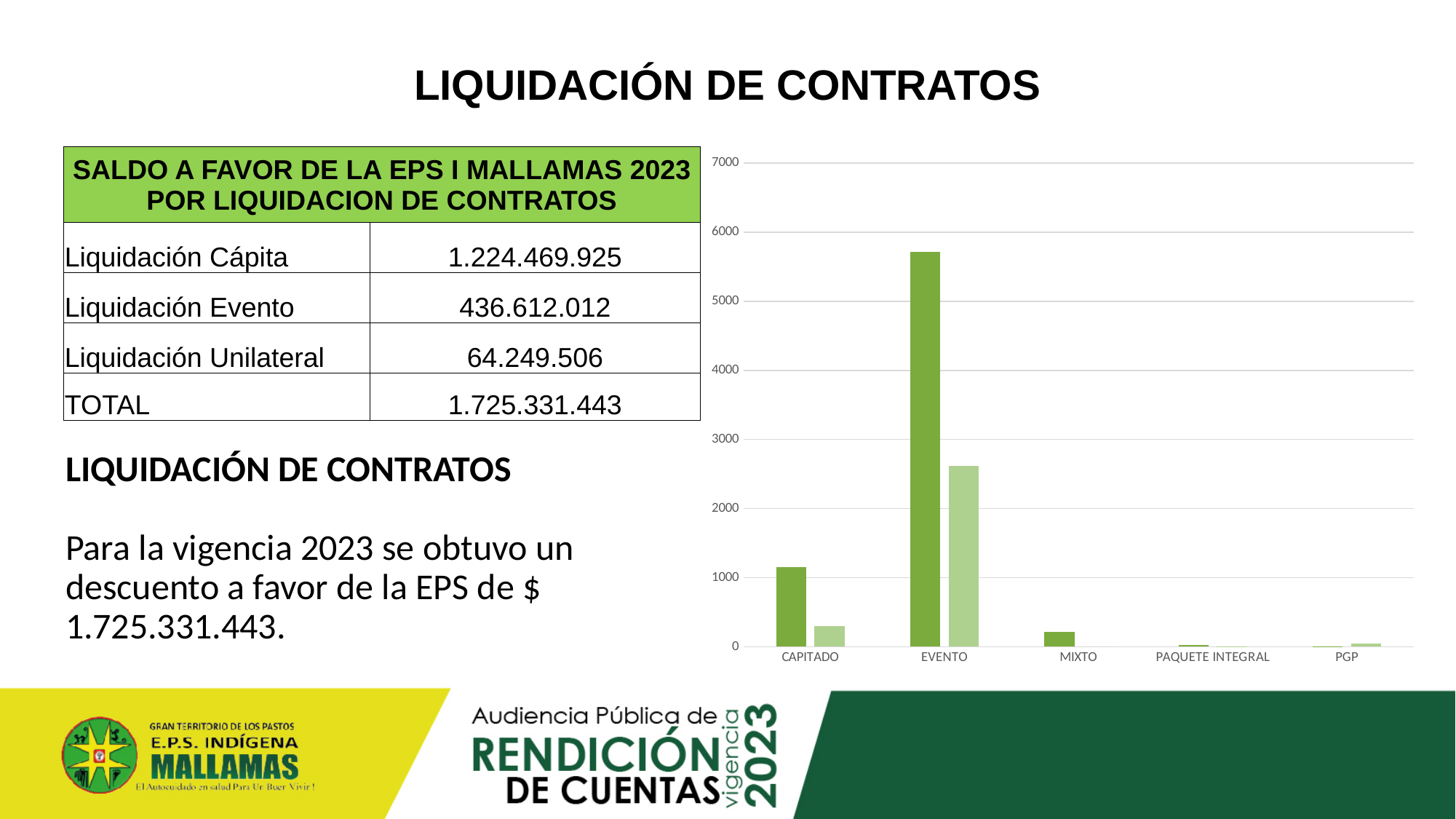
How many categories are shown on the x axis of the bar chart? 5 Is the value of the dark green bar for EVENTO greater or less than 6000? less Is the value of the light green bar for EVENTO greater or less than 2000? greater Is the value of the light green bar for CAPITADO greater or less than 1000? less Which has a larger dark green bar, EVENTO or CAPITADO? EVENTO What kind of chart is shown on the right side of the slide? bar chart Which has a larger dark green bar, CAPITADO or MIXTO? CAPITADO Which category has the tallest bar in the bar chart? EVENTO What is the highest value shown on the y axis of the bar chart? 7000